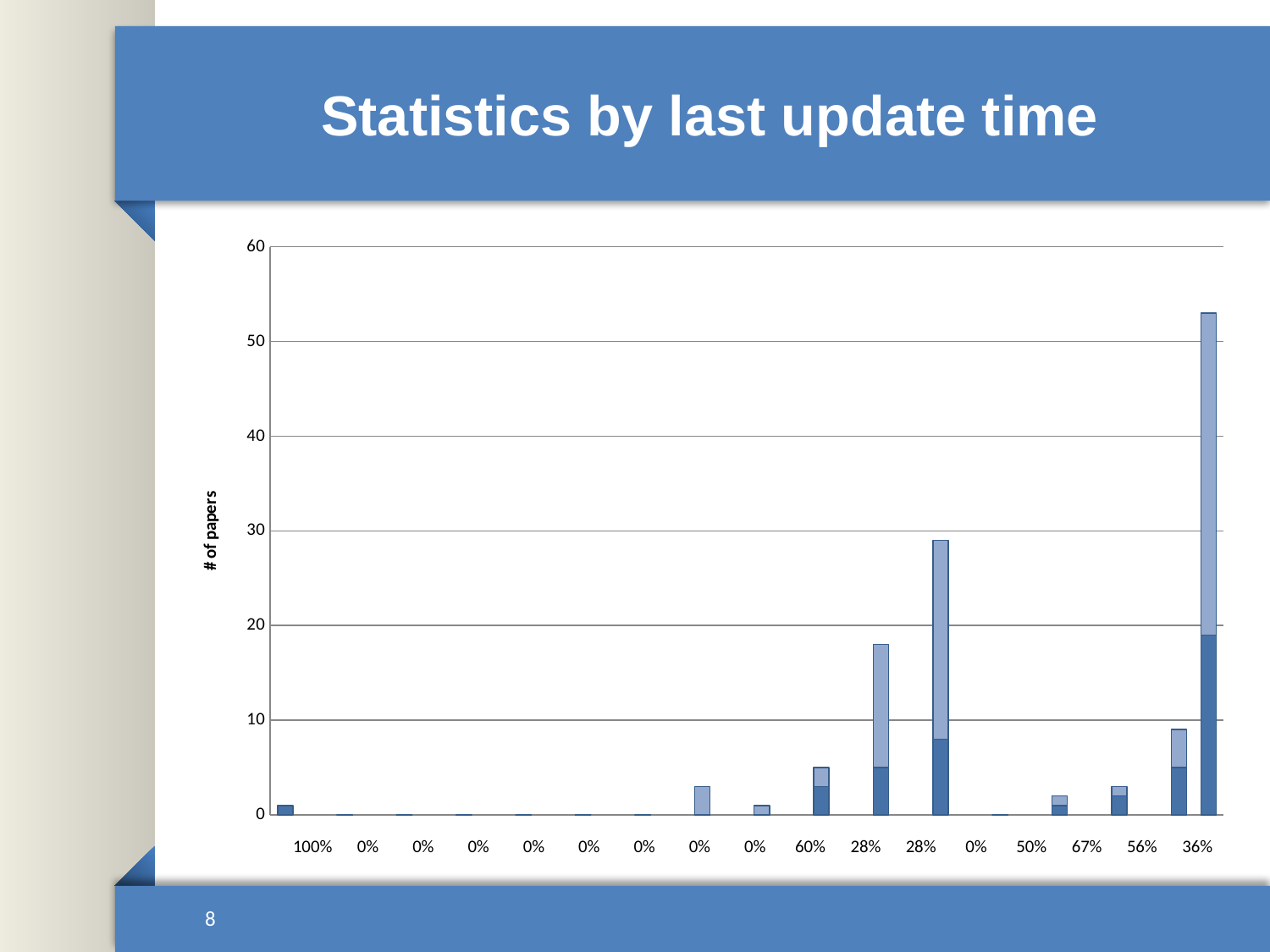
What kind of chart is shown on the slide? bar chart Which bar is taller, the one labelled 100% or the one labelled 60%? 60% What is the title of the chart on the slide? Statistics by last update time Is the value for the bar labelled 60% greater or less than 10? less How many categories are shown along the x axis of the chart? 17 Is the value for the bar labelled 100% greater or less than 10? less Is the value for the bar labelled 50% greater or less than 10? less Which category has the tallest bar in the chart? 36% Which bar is taller, the one labelled 36% or the one labelled 60%? 36% What is the label on the vertical axis of the chart? # of papers